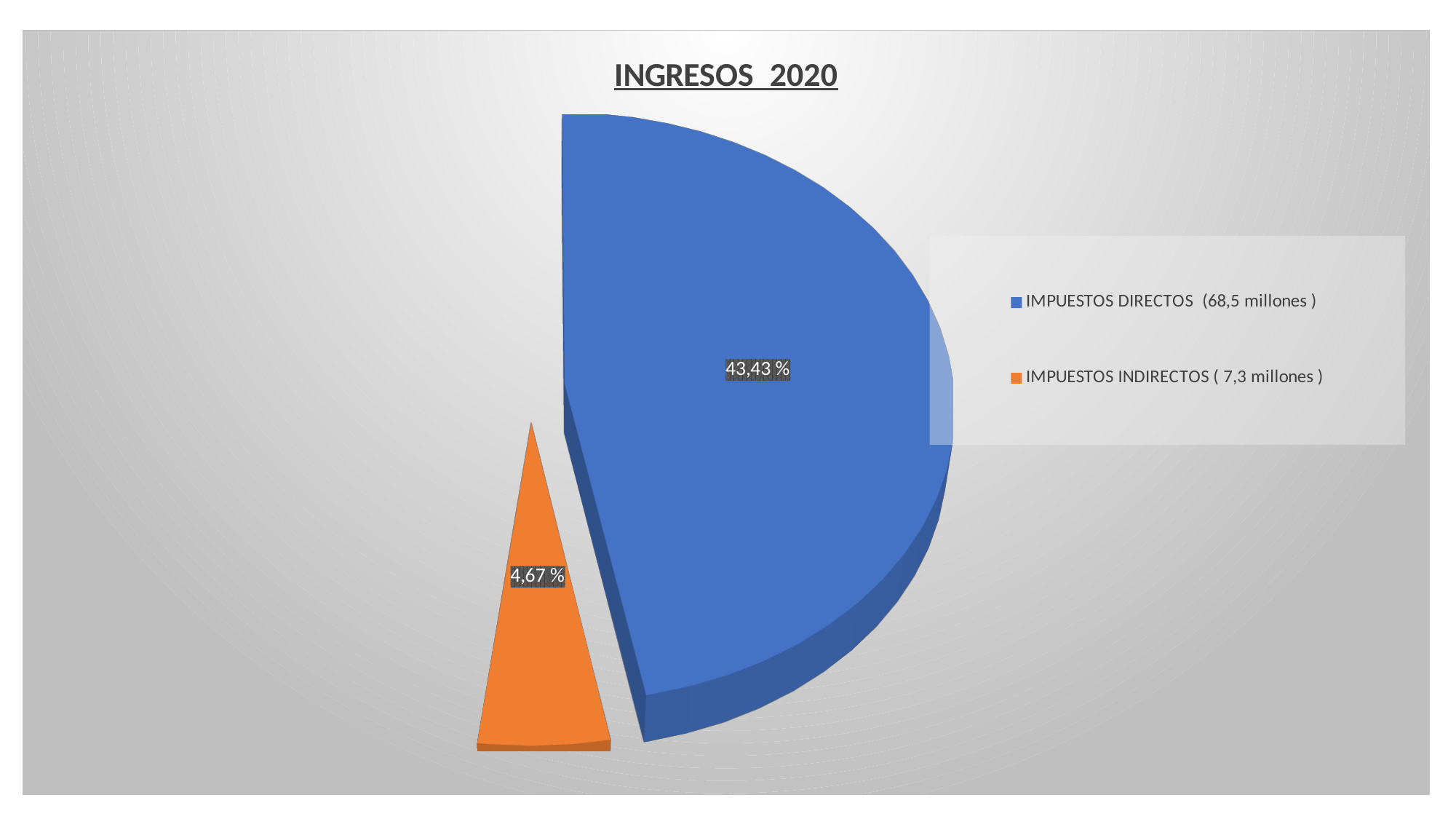
How many categories does the legend list? 2 What percentage is shown for IMPUESTOS INDIRECTOS? 4,67 % What amount in millions is given in the legend for IMPUESTOS DIRECTOS? 68,5 millones What is the title of the chart? INGRESOS 2020 What percentage is shown for IMPUESTOS DIRECTOS? 43,43 % What colour is the slice for IMPUESTOS INDIRECTOS? orange What kind of chart is shown on the slide? pie chart Which category has the largest slice in the pie chart? IMPUESTOS DIRECTOS What amount in millions is given in the legend for IMPUESTOS INDIRECTOS? 7,3 millones Which is larger, the slice for IMPUESTOS DIRECTOS or the slice for IMPUESTOS INDIRECTOS? IMPUESTOS DIRECTOS What is the difference in percentage points between the IMPUESTOS DIRECTOS slice and the IMPUESTOS INDIRECTOS slice? 38,76 % Which category has the smallest slice in the pie chart? IMPUESTOS INDIRECTOS